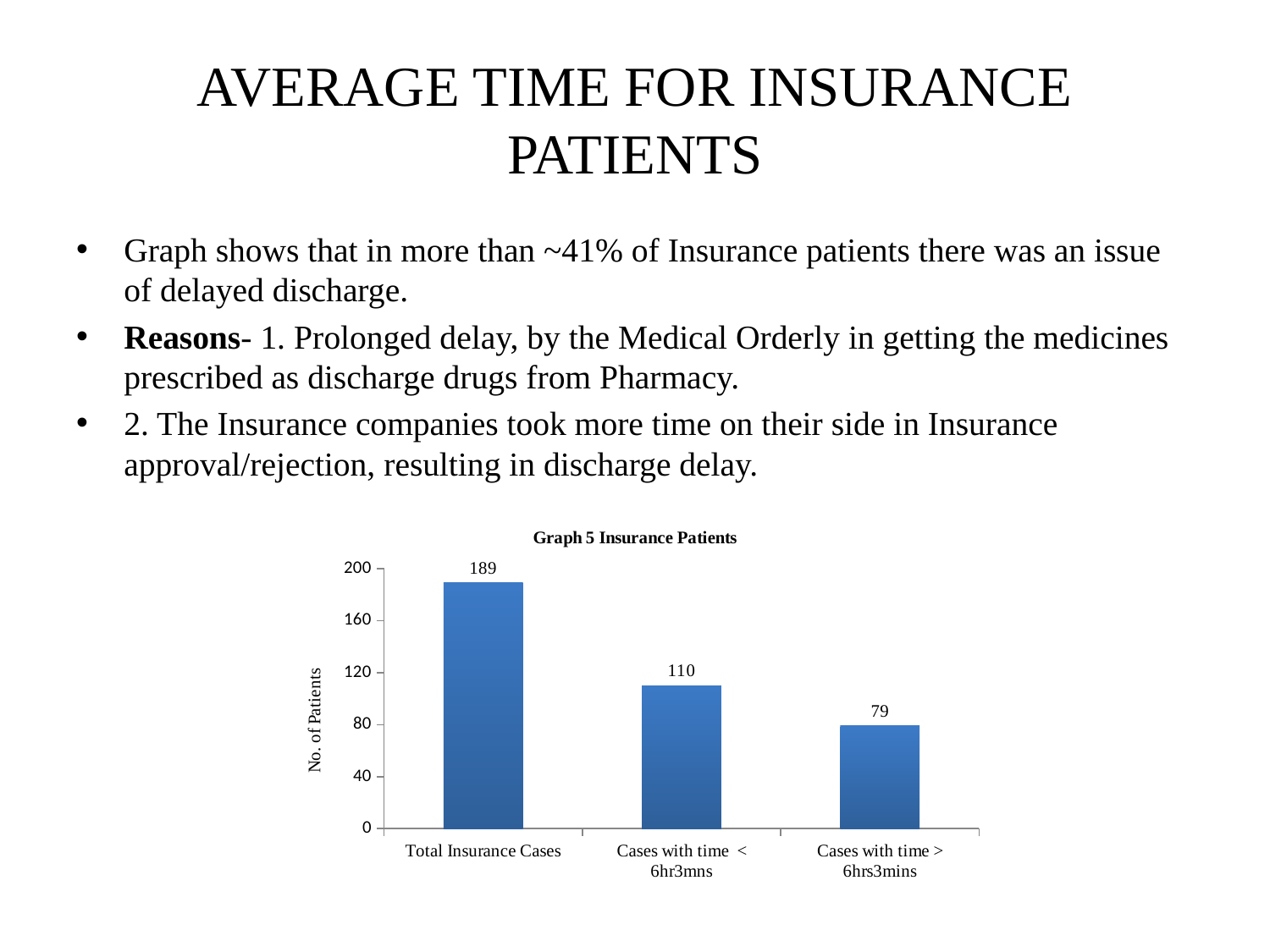
What is the value for Cases with time < 6hr3mns? 110 What is the difference between Cases with time < 6hr3mns and Cases with time > 6hrs3mins? 31 Which category has the highest value? Total Insurance Cases What kind of chart is shown on the slide? bar chart Which category has the lowest value? Cases with time > 6hrs3mins Is the value for Cases with time > 6hrs3mins greater or less than 80? less What is the title of the chart? Graph 5 Insurance Patients What is the value for Total Insurance Cases? 189 What is the value for Cases with time > 6hrs3mins? 79 What is the difference between Total Insurance Cases and Cases with time < 6hr3mns? 79 Which is larger, Cases with time < 6hr3mns or Cases with time > 6hrs3mins? Cases with time < 6hr3mns How many categories are shown on the chart? 3